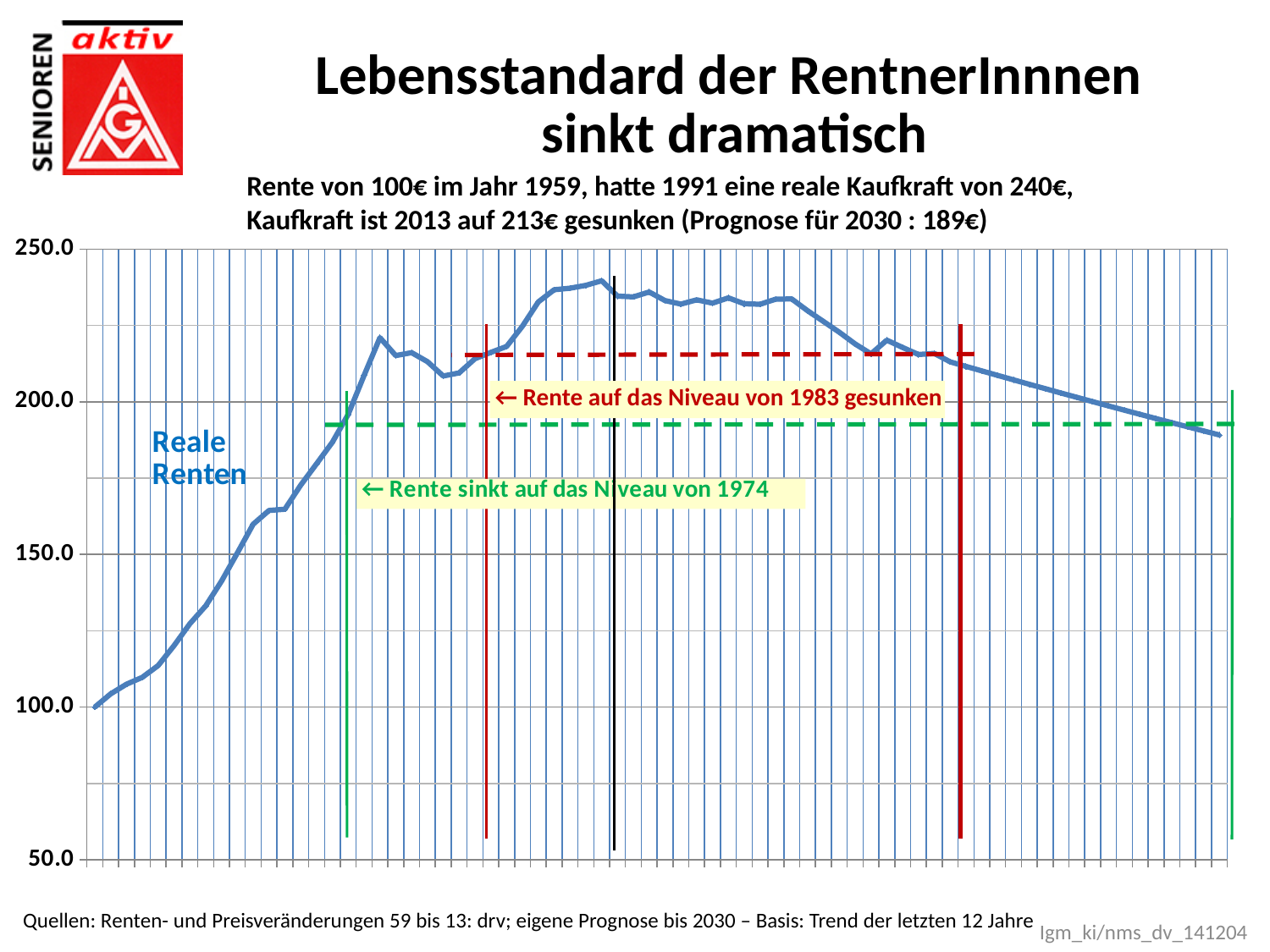
Is the value at the right end of the blue line greater or less than 200? less What is the difference between the 2013 value and the 2030 forecast stated on the slide? 24€ What label is written next to the blue line in the chart? Reale Renten According to the slide, to what value had the purchasing power sunk by 2013? 213€ Is the peak value of the blue line greater or less than 200? greater What is the difference between the 1991 purchasing power and the 2013 purchasing power stated on the slide? 27€ What is the forecast (Prognose) value for 2030 given on the slide? 189€ What is the highest value shown on the vertical axis? 250.0 What kind of chart is shown on the slide? line chart What is the title of the slide containing the chart? Lebensstandard der RentnerInnnen sinkt dramatisch Does the blue line rise or fall over the right-hand portion of the chart, after its peak? fall According to the slide, what real purchasing power did a pension of 100€ from 1959 have in 1991? 240€